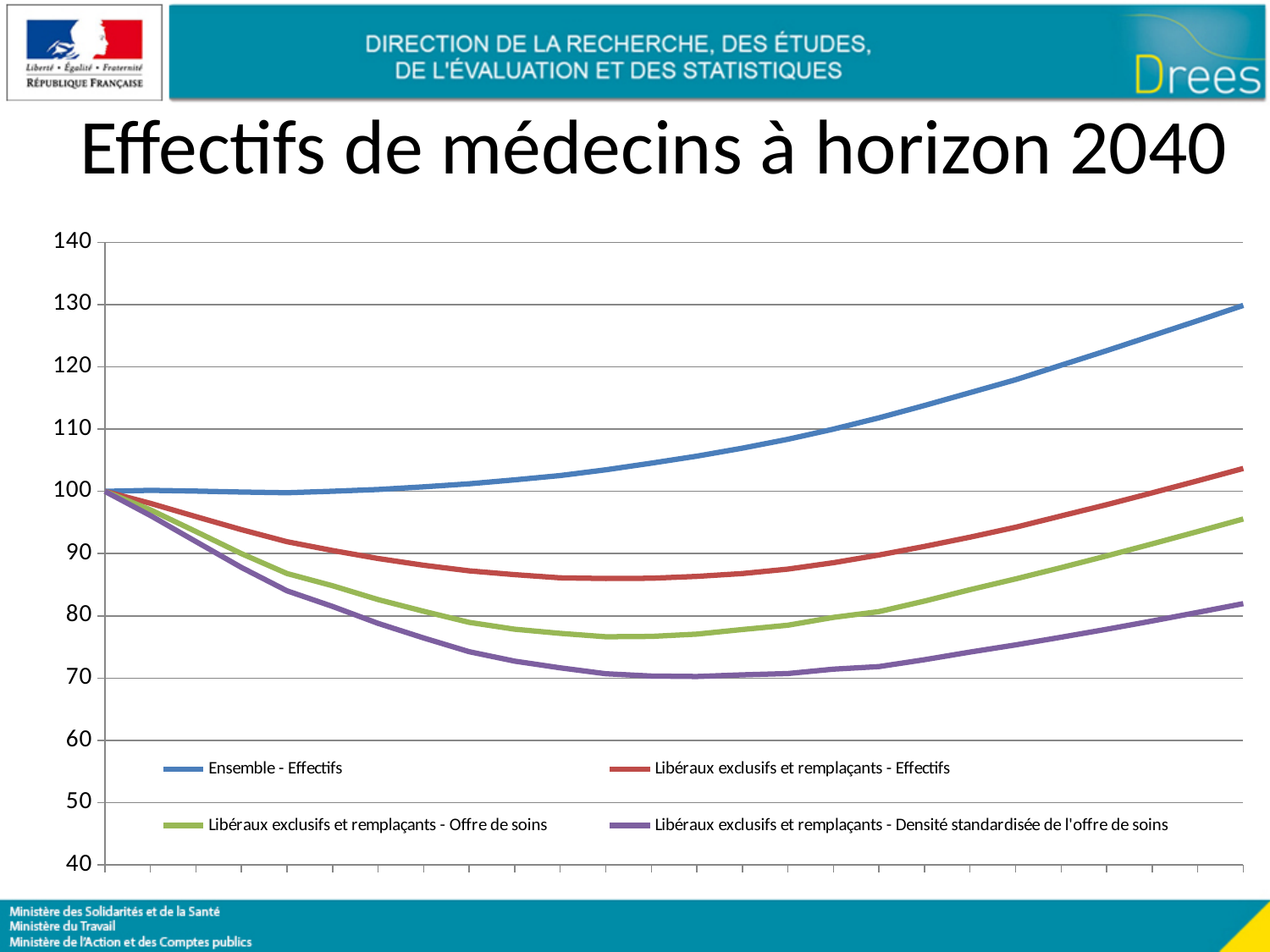
Which series has the highest value at the right edge of the chart? Ensemble - Effectifs At what value do all four series start at the left edge of the chart? 100 Is the lowest point of the 'Libéraux exclusifs et remplaçants - Densité standardisée de l'offre de soins' series greater or less than 80? less What is the title of the chart? Effectifs de médecins à horizon 2040 What kind of chart is shown on the slide? line chart Which series is drawn in blue? Ensemble - Effectifs Is the lowest point of the 'Libéraux exclusifs et remplaçants - Effectifs' series greater or less than 80? greater Is the value of 'Ensemble - Effectifs' at the right edge of the chart greater or less than 120? greater How many series does the legend list? 4 Does the 'Ensemble - Effectifs' series rise or fall overall from left to right? rise Which series has the lowest value at the right edge of the chart? Libéraux exclusifs et remplaçants - Densité standardisée de l'offre de soins At the right edge of the chart, which is larger: 'Libéraux exclusifs et remplaçants - Effectifs' or 'Libéraux exclusifs et remplaçants - Offre de soins'? Libéraux exclusifs et remplaçants - Effectifs